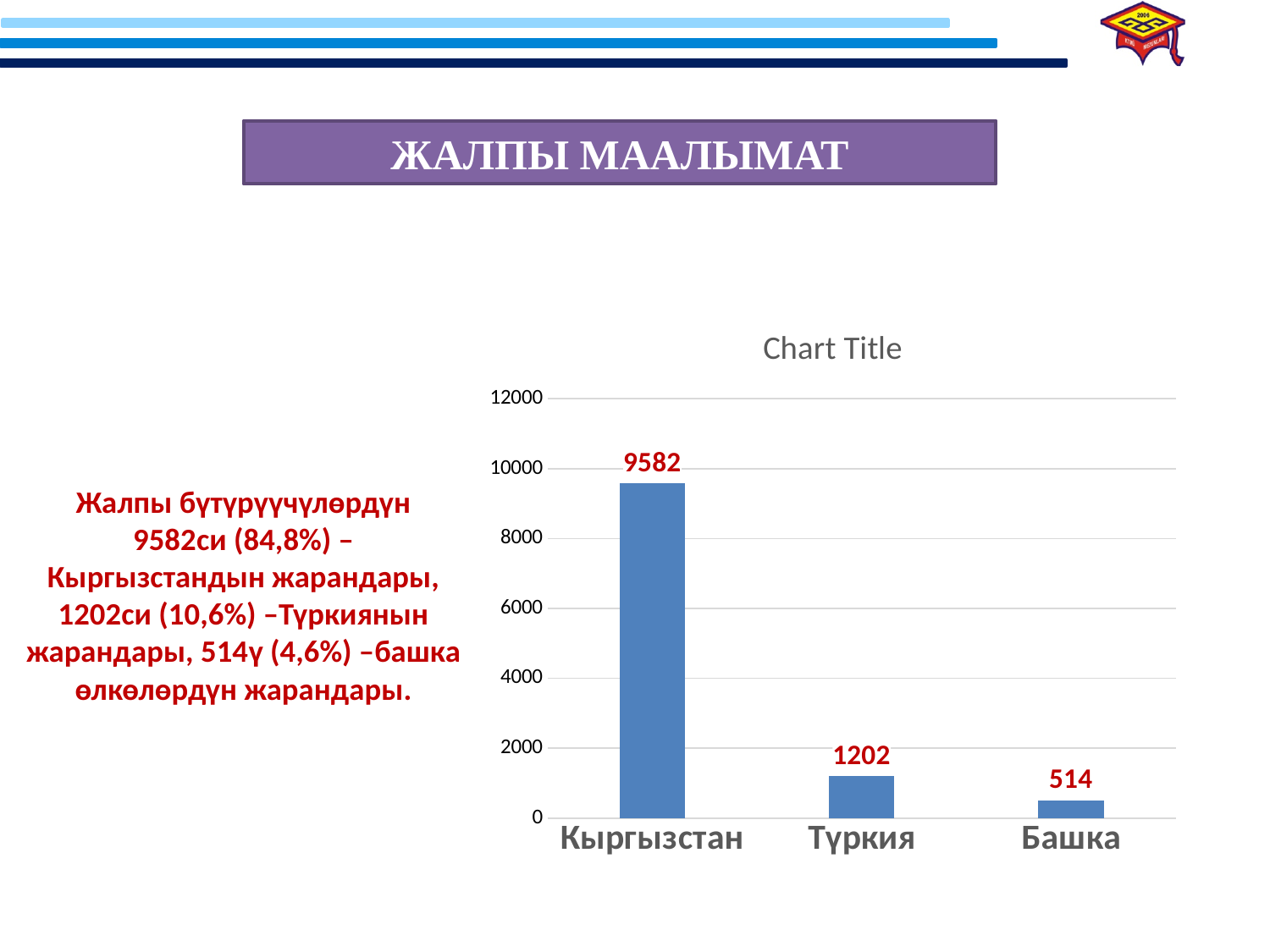
Which category has the highest value? Кыргызстан What is the difference between the values for Түркия and Башка? 688 How many categories are shown on the x axis? 3 What is the title shown above the chart? Chart Title Which category has the lowest value? Башка What kind of chart is shown on the slide? bar chart What is the difference between the values for Кыргызстан and Түркия? 8380 What is the value for Башка? 514 Is the value for Кыргызстан greater or less than 8000? greater Which is larger, the value for Түркия or the value for Башка? Түркия What is the value for Кыргызстан? 9582 What is the value for Түркия? 1202